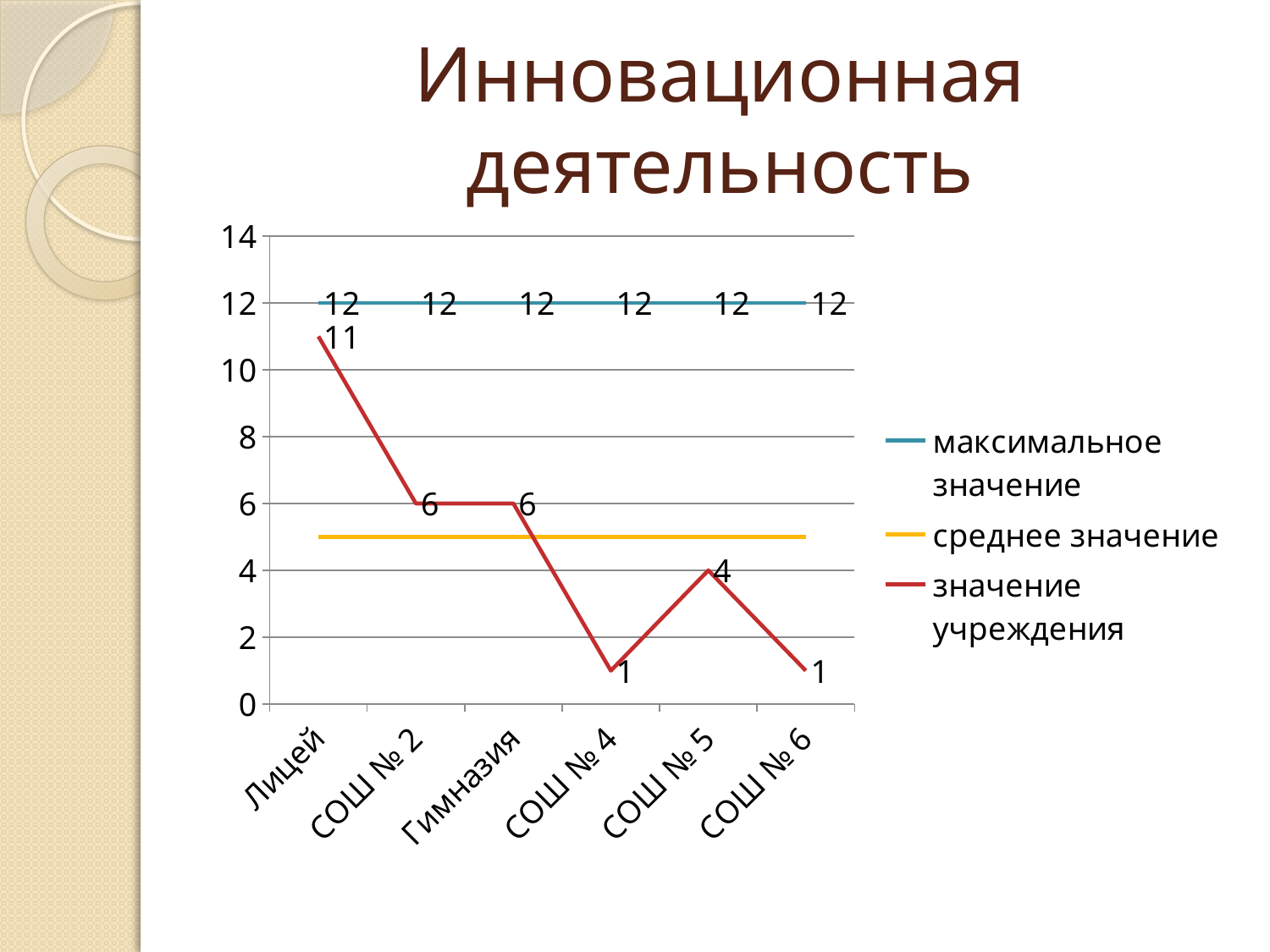
What kind of chart is shown on the slide? line chart What is the difference between the "максимальное значение" and the "значение учреждения" for СОШ № 2? 6 What is the value of "максимальное значение" for Гимназия? 12 What is the difference between the "значение учреждения" for Лицей and for СОШ № 4? 10 What is the value of "значение учреждения" for Лицей? 11 Which category has the highest value for "значение учреждения"? Лицей What is the value of "значение учреждения" for СОШ № 5? 4 Which is larger, the "значение учреждения" for Гимназия or for СОШ № 5? Гимназия How many series does the legend list? 3 Is the value of "среднее значение" greater or less than 6? less How many categories are shown on the x axis? 6 What is the title of the chart on the slide? Инновационная деятельность